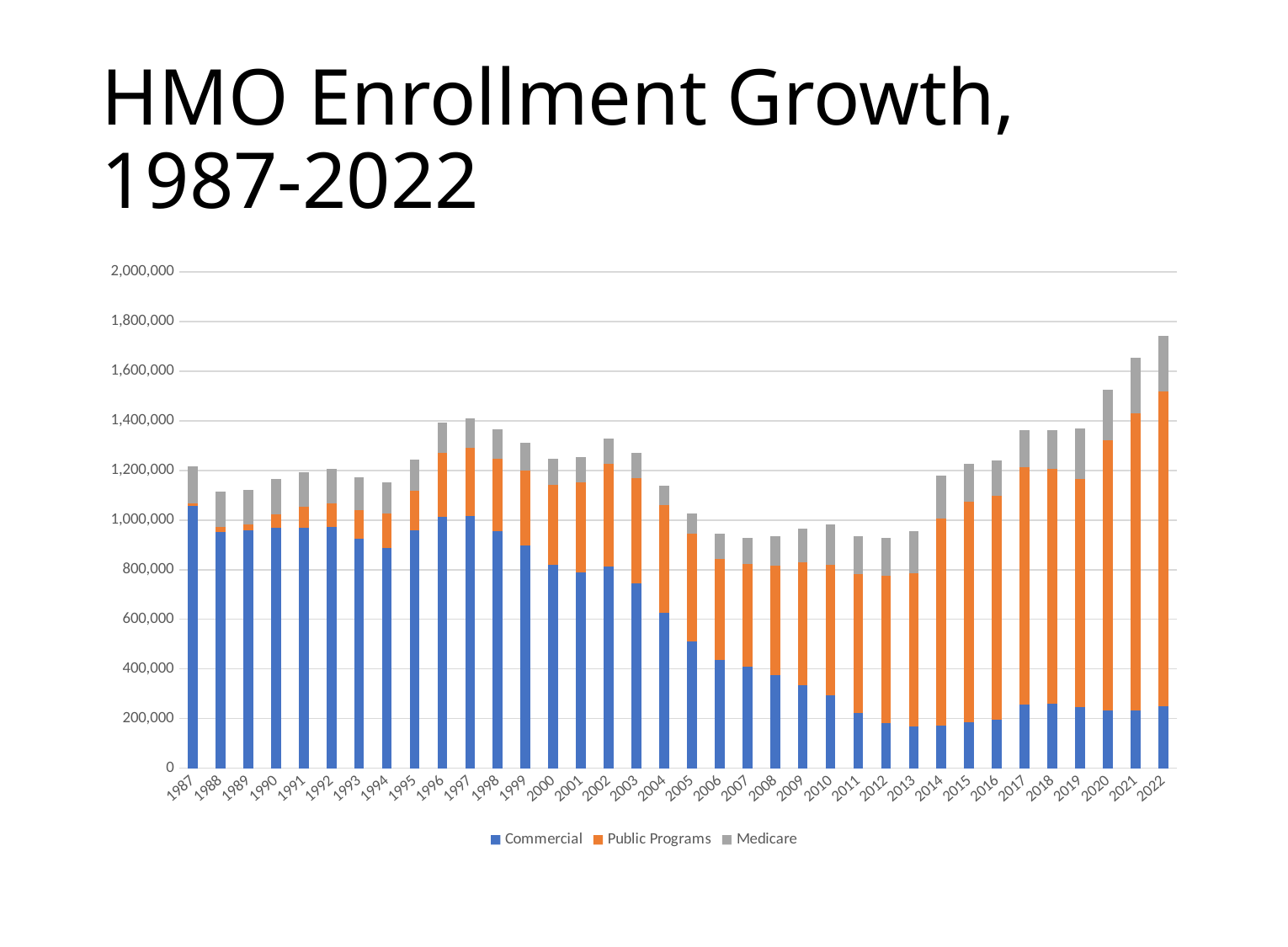
Is the Commercial enrollment for 1987 greater or less than 1,000,000? greater How many series does the legend list? 3 Is the Commercial enrollment for 2022 greater or less than 400,000? less Is the total enrollment for 2022 greater or less than 1,600,000? greater Does Commercial enrollment rise or fall from 1997 to 2013? fall Which year has the highest total HMO enrollment? 2022 What kind of chart is shown on the slide? Stacked bar chart Which year has the larger Commercial enrollment, 1987 or 2022? 1987 Which year has the larger total enrollment, 1987 or 2022? 2022 How many years are shown along the x axis? 36 What is the title of the chart? HMO Enrollment Growth, 1987-2022